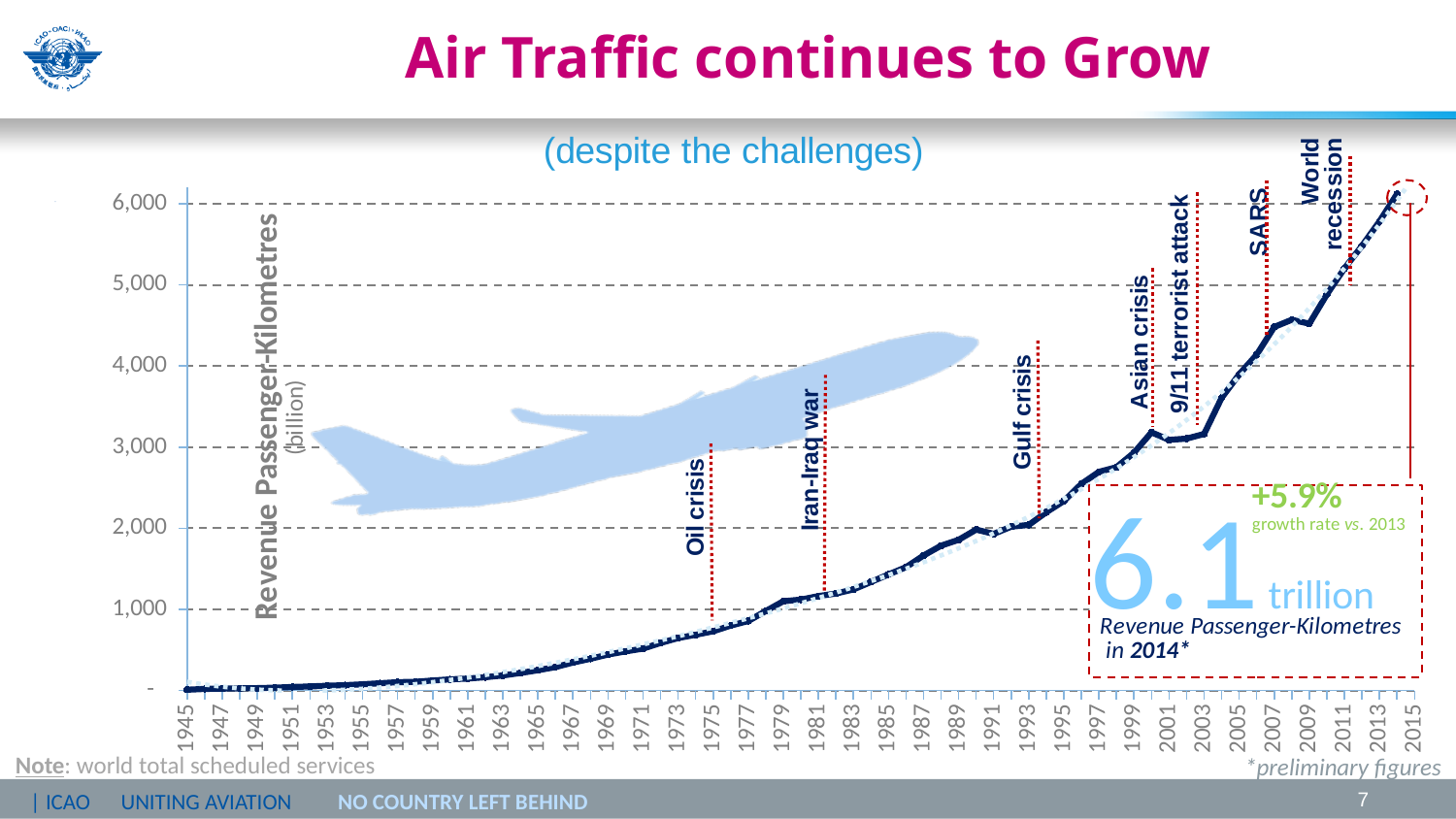
Is the value for 1997 greater or less than 2,000? greater According to the callout on the chart, what were the Revenue Passenger-Kilometres in 2014? 6.1 trillion What quantity does the vertical axis of the chart measure? Revenue Passenger-Kilometres (billion) What is the title of the chart on the slide? Air Traffic continues to Grow Which is larger, the value for 1985 or the value for 2001? 2001 What kind of chart is shown on the slide? line chart What growth rate vs. 2013 is shown in the callout on the chart? +5.9% Is the value for 2007 greater or less than 4,000? greater Is the value for 1965 greater or less than 1,000? less Which year has the lowest value on the chart? 1945 Do the values in the chart generally rise or fall from 1945 to 2015? rise